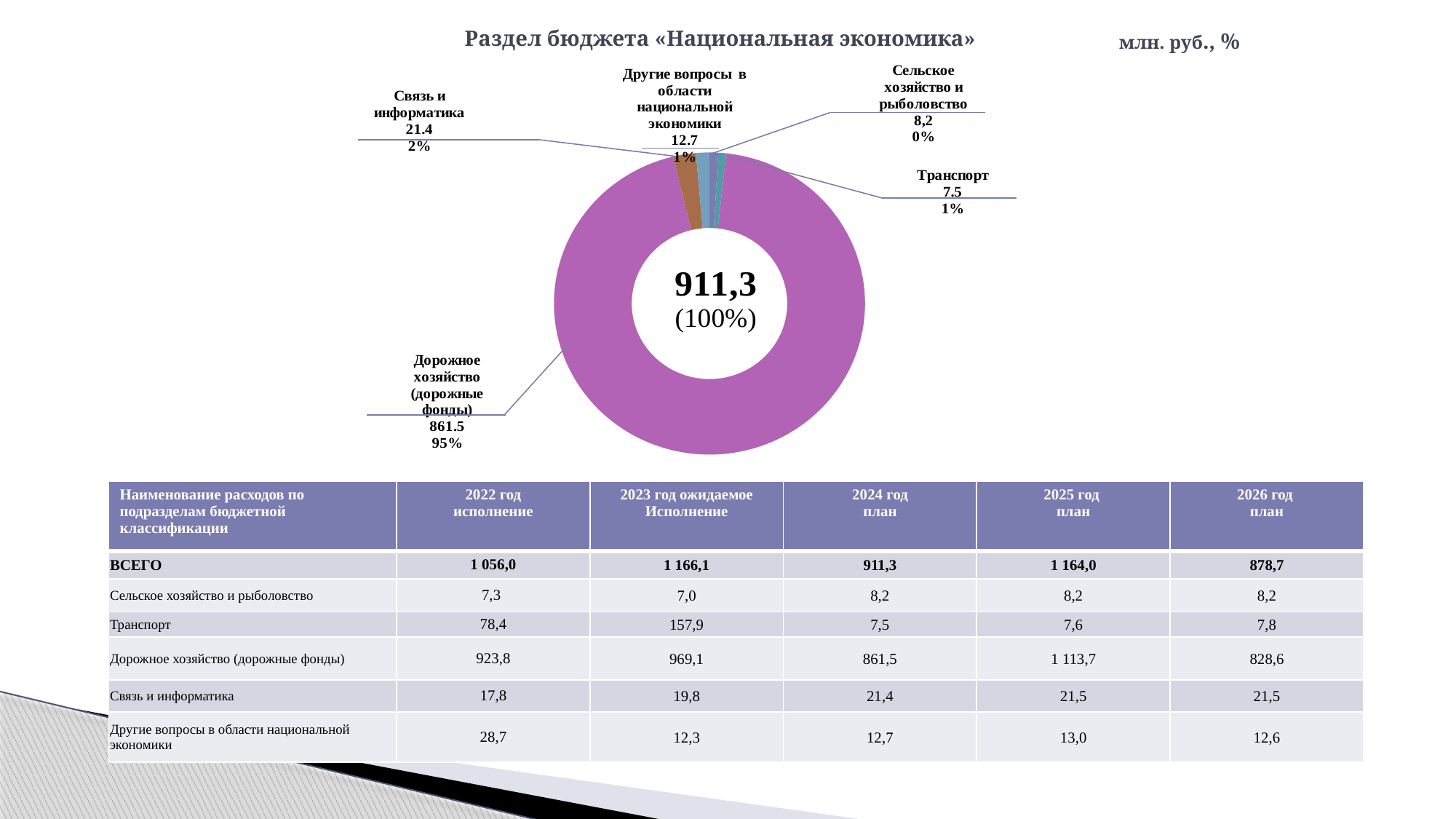
What is the difference between the values for «Связь и информатика» and «Другие вопросы в области национальной экономики» in the donut chart? 8.7 Which is larger in the donut chart: «Сельское хозяйство и рыболовство» or «Транспорт»? Сельское хозяйство и рыболовство What value is shown for «Дорожное хозяйство (дорожные фонды)» in the donut chart? 861.5 What value is shown for «Транспорт» in the donut chart? 7.5 What kind of chart is shown on the slide? Donut (pie) chart Which category has the smallest value in the donut chart? Транспорт What share of the donut chart does «Дорожное хозяйство (дорожные фонды)» account for? 95% What share is shown for «Сельское хозяйство и рыболовство» in the donut chart? 0% Which category has the largest slice in the donut chart? Дорожное хозяйство (дорожные фонды) How many categories (slices) does the donut chart show? 5 What value is shown for «Связь и информатика» in the donut chart? 21.4 What total value is shown in the centre of the donut chart? 911,3